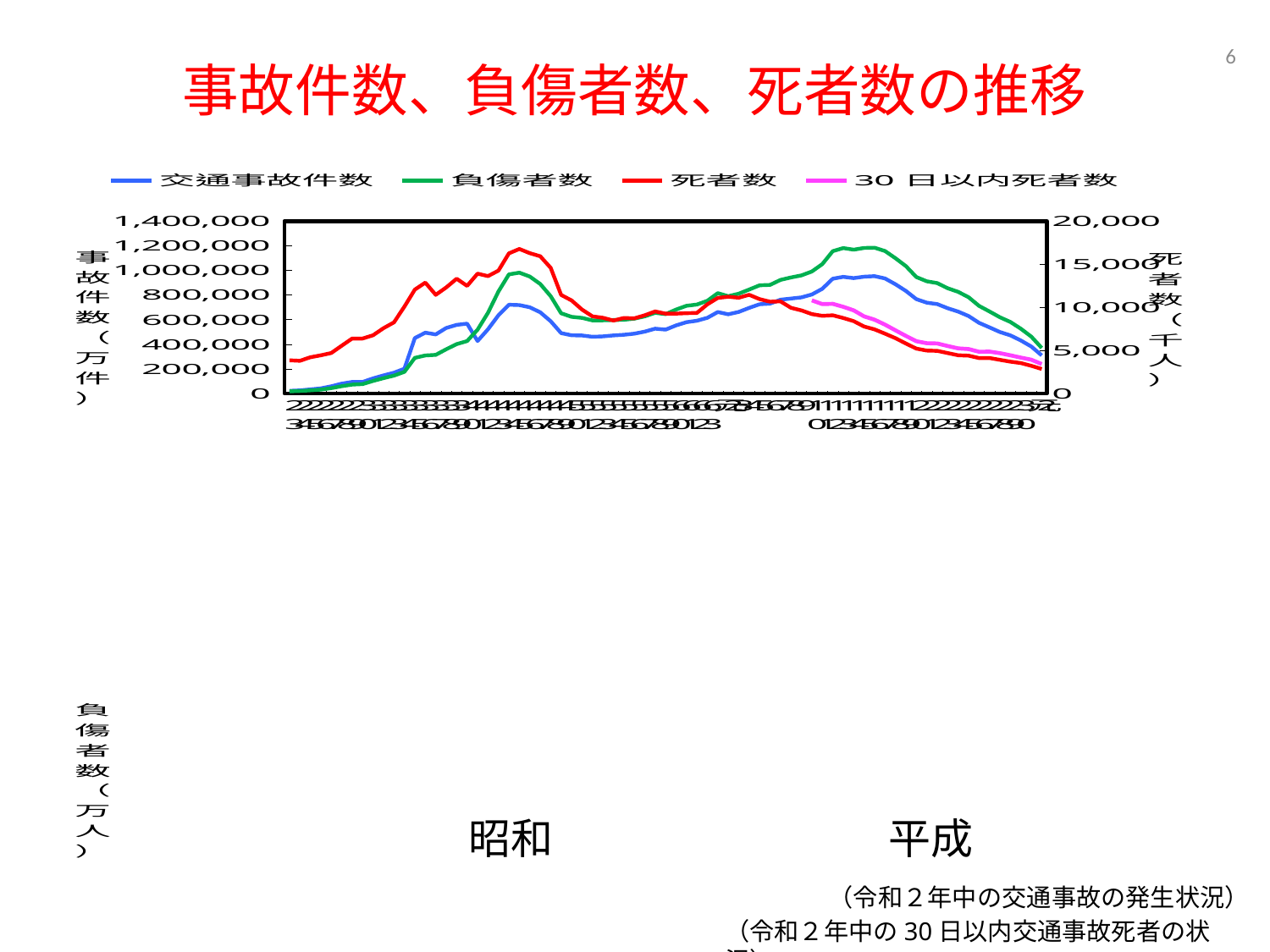
What is the maximum value shown on the left vertical axis? 1,400,000 Is the peak value of 負傷者数 greater or less than 1,000,000 on the left axis? greater Is the peak value of 死者数 greater or less than 15,000 on the right axis? greater Does the 交通事故件数 line rise or fall over the last part of the chart (after its 平成 peak)? fall Does the 死者数 line rise or fall over the 平成 period toward the right end of the chart? fall At the right end of the chart, is the value of 30 日以内死者数 greater or less than 5,000 on the right axis? less What is the title of the chart on the slide? 事故件数、負傷者数、死者数の推移 What kind of chart is shown on the slide? line chart What is the maximum value shown on the right vertical axis? 20,000 Which series reaches a higher peak on the left axis, 負傷者数 or 交通事故件数? 負傷者数 Which series is drawn in magenta (pink)? 30 日以内死者数 How many series does the legend list? 4